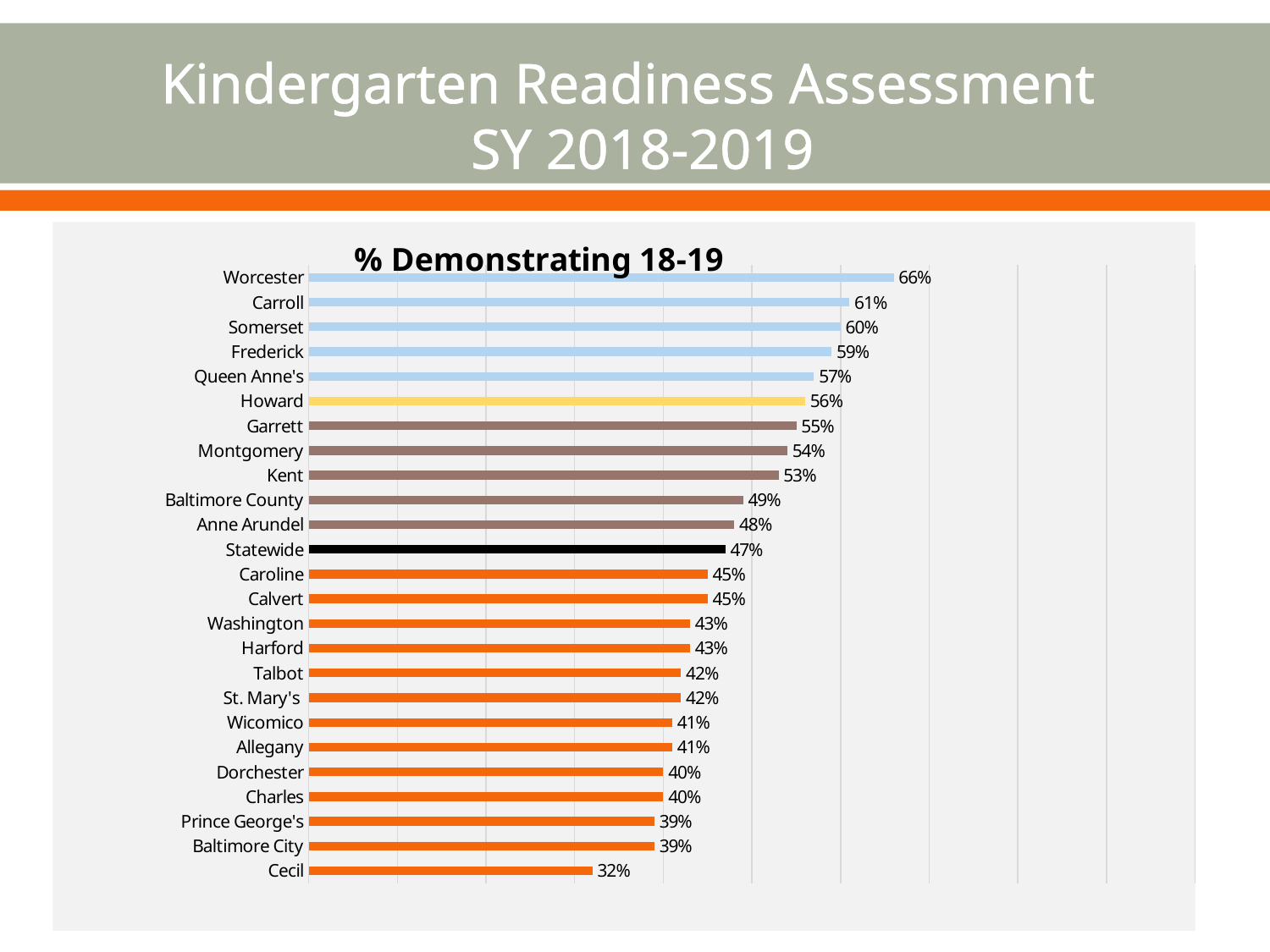
Which is larger, the value for Montgomery or the value for Anne Arundel? Montgomery What is the title of the chart? % Demonstrating 18-19 Which category has the lowest value? Cecil What kind of chart is shown on the slide? Bar chart What is the difference between the values for Worcester and Cecil? 34% Which category has the highest value? Worcester What is the value for Howard? 56% How many categories are plotted in the chart? 25 What is the difference between the values for Howard and Statewide? 9% What is the value for Statewide? 47% What is the value for Baltimore City? 39% Which is larger, the value for Kent or the value for Frederick? Frederick